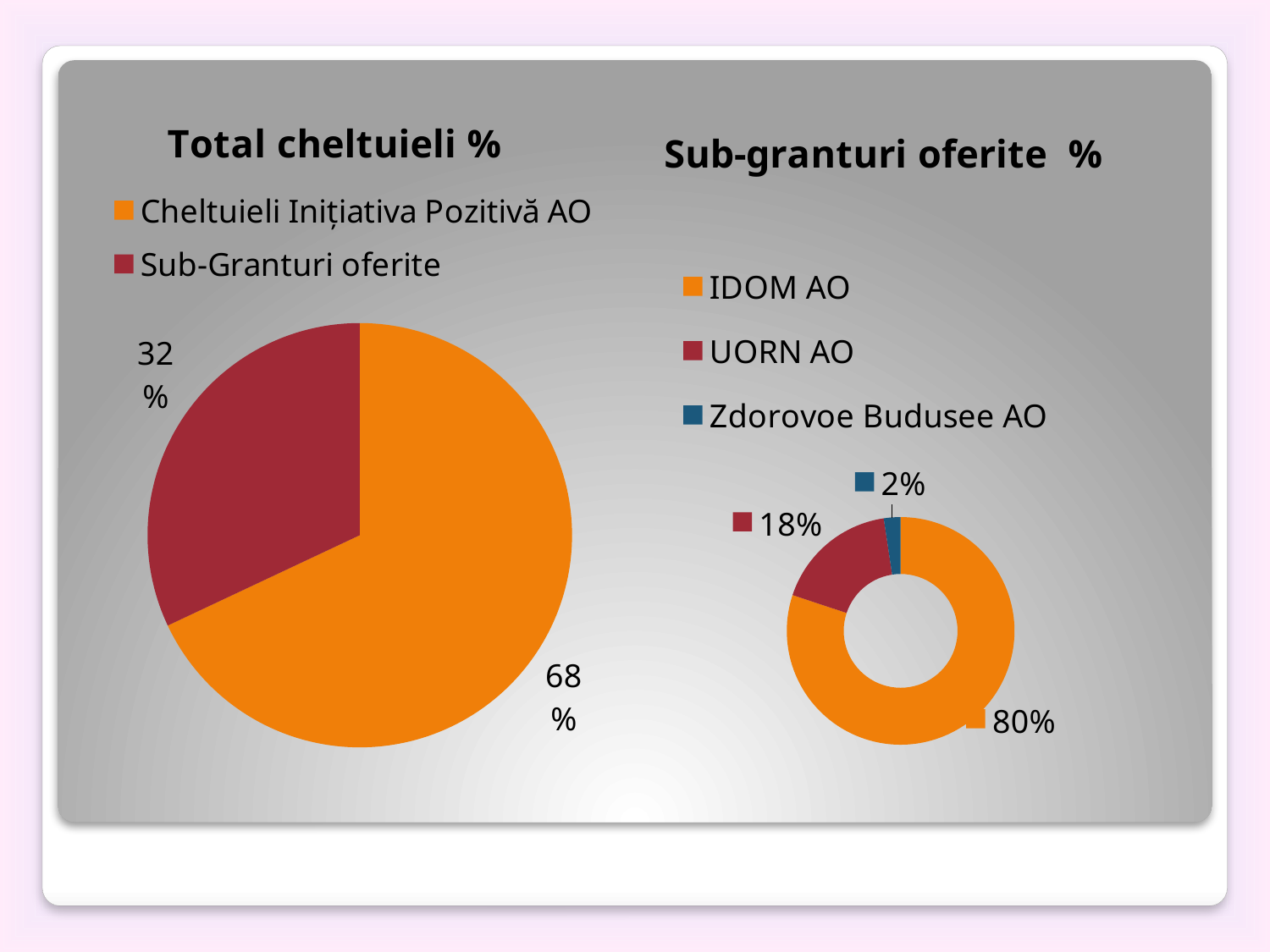
In the 'Sub-granturi oferite %' chart, which category has the smallest share? Zdorovoe Budusee AO In the 'Sub-granturi oferite %' chart, what is the value for Zdorovoe Budusee AO? 2% In the 'Total cheltuieli %' chart, which category has the largest share? Cheltuieli Inițiativa Pozitivă AO What kind of chart is the 'Total cheltuieli %' chart? Pie chart In the 'Sub-granturi oferite %' chart, how many categories are shown? 3 How many categories does the legend of the 'Total cheltuieli %' chart list? 2 In the 'Sub-granturi oferite %' chart, what is the difference between the IDOM AO share and the UORN AO share? 62% In the 'Total cheltuieli %' chart, what is the value for Sub-Granturi oferite? 32% In the 'Sub-granturi oferite %' chart, what is the value for IDOM AO? 80% In the 'Total cheltuieli %' chart, what is the value for Cheltuieli Inițiativa Pozitivă AO? 68% In the 'Total cheltuieli %' chart, what is the difference between the Cheltuieli Inițiativa Pozitivă AO share and the Sub-Granturi oferite share? 36% In the 'Sub-granturi oferite %' chart, what is the value for UORN AO? 18%